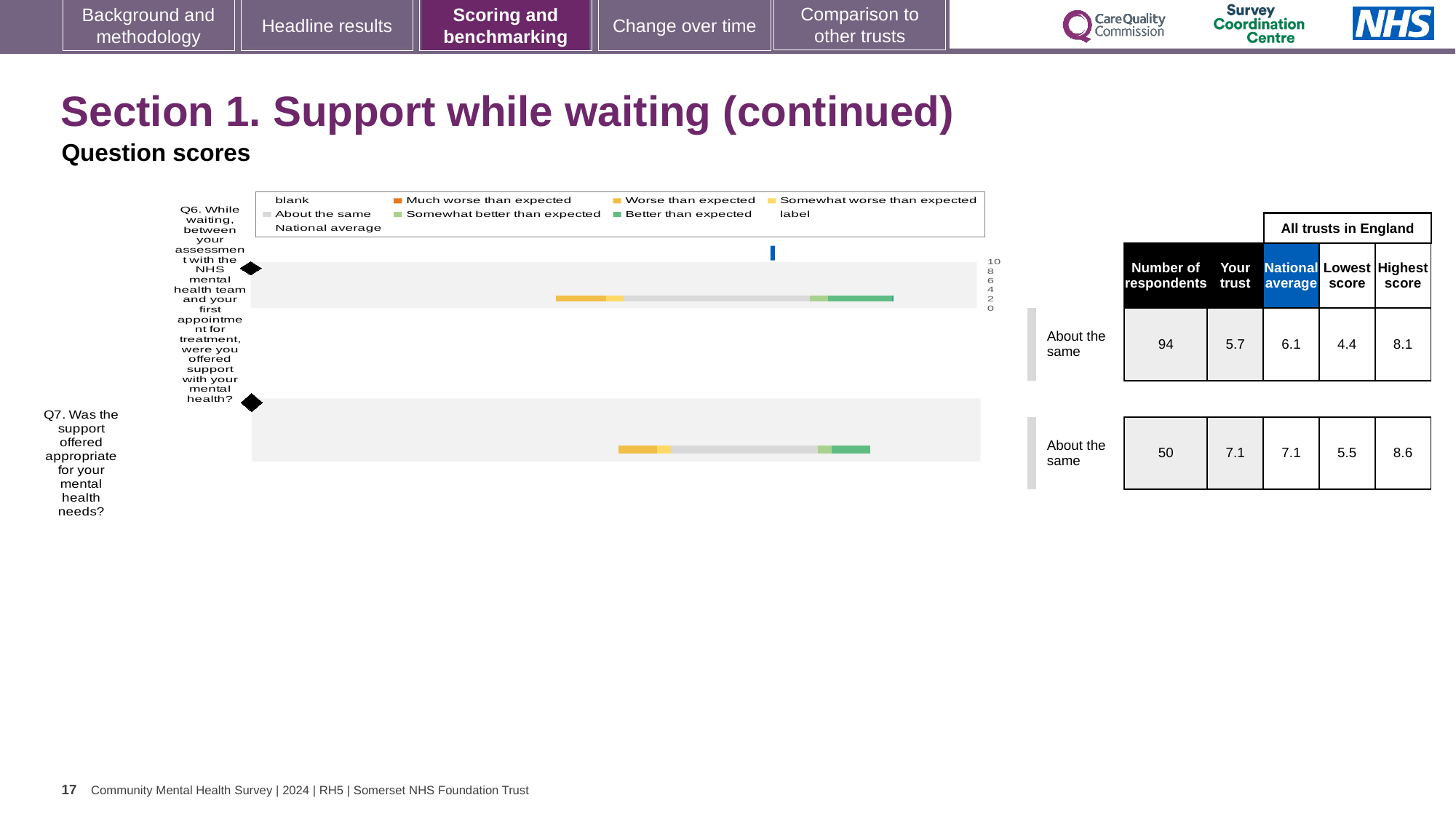
What colour does the legend use for "Better than expected"? green For Q6, what is the difference between the highest score and the lowest score among all trusts in England? 3.7 What benchmark category is shown for Q7? About the same For Q6, which is larger: the "Your trust" score or the national average? National average How many questions are plotted in the chart? 2 What is the national average score for Q7? 7.1 What is the lowest score among all trusts in England for Q7? 5.5 How many respondents are shown for Q6? 94 What kind of chart is used to show the question scores for Q6 and Q7? bar chart What is the highest score among all trusts in England for Q7? 8.6 What is the "Your trust" score for Q6? 5.7 What colour does the legend use for "Much worse than expected"? orange